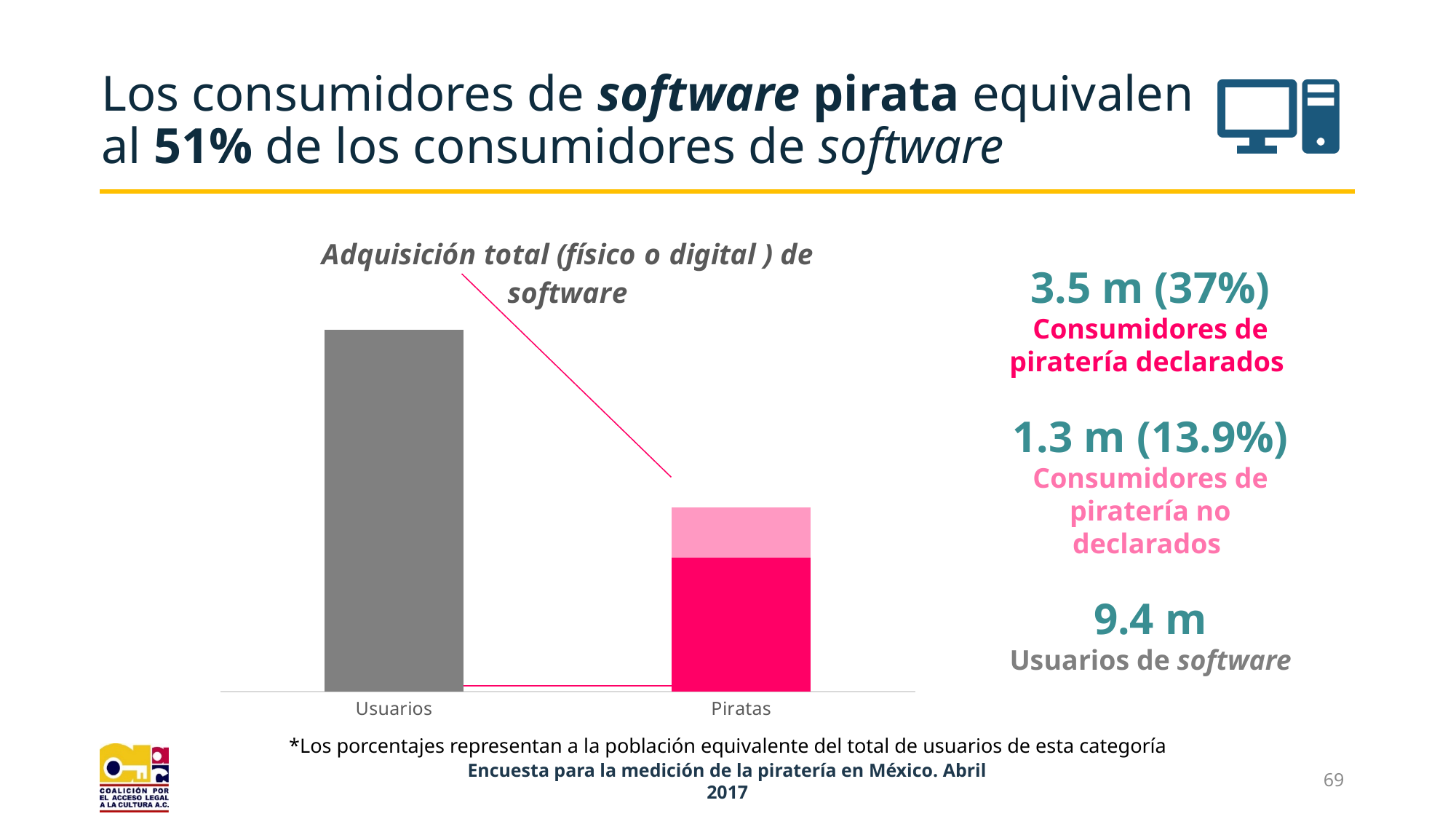
Which category's bar is split into two coloured segments? Piratas Is the bar for Usuarios taller or shorter than the bar for Piratas? taller What value is given on the slide for Consumidores de piratería declarados? 3.5 m (37%) What value is given on the slide for Consumidores de piratería no declarados? 1.3 m (13.9%) What kind of chart is shown on the slide? bar chart What value is given on the slide for Usuarios de software? 9.4 m What is the total of the stacked Piratas bar, combining declared (3.5 m) and undeclared (1.3 m) piracy consumers? 4.8 m Which category has the shortest bar in the chart? Piratas What is the title of the chart? Adquisición total (físico o digital ) de software Which category has the tallest bar in the chart? Usuarios How many categories are shown on the x axis of the chart? 2 What is the difference between the declared piracy consumers (3.5 m) and the undeclared piracy consumers (1.3 m)? 2.2 m